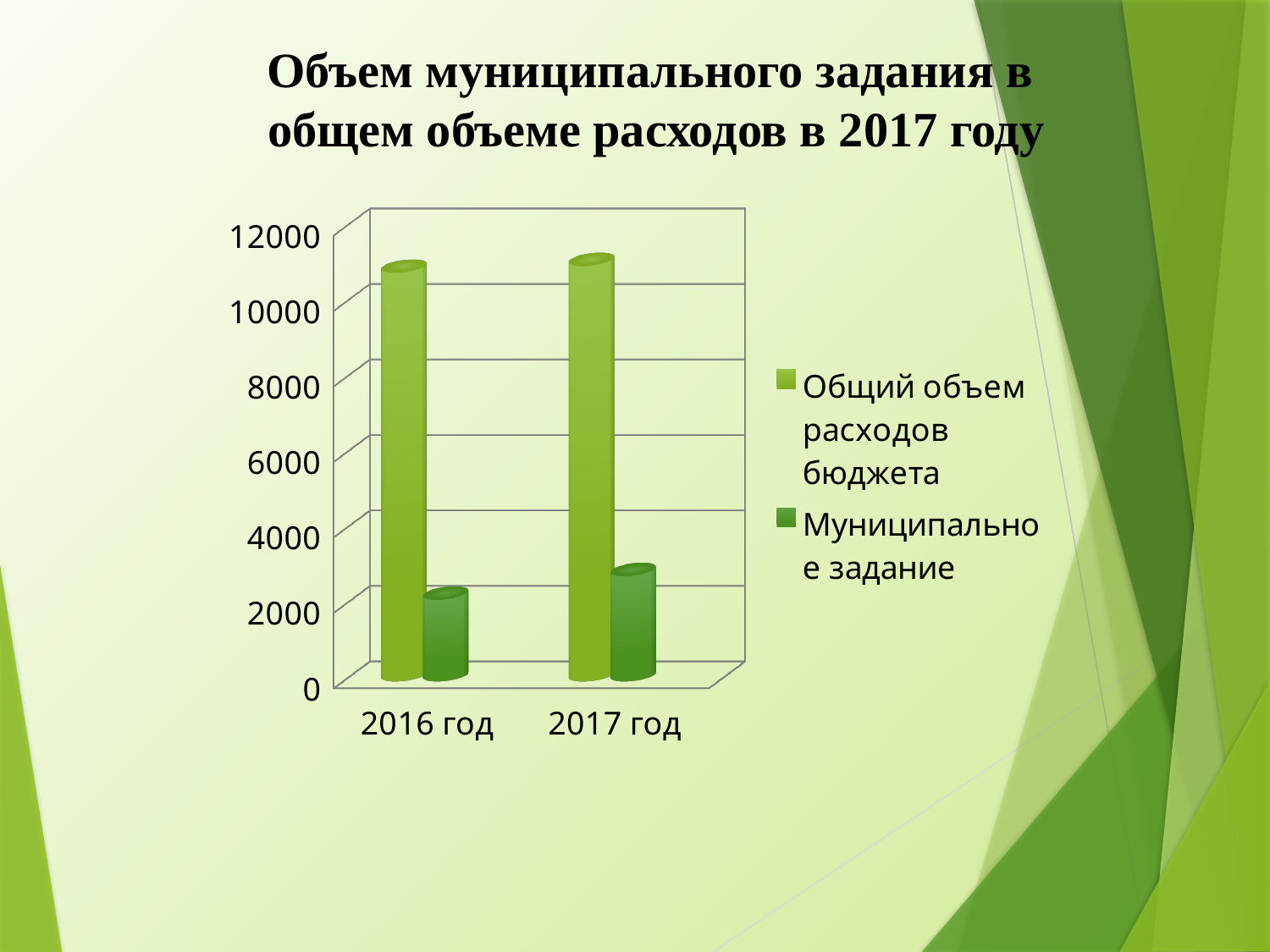
In 2017 год, which is larger: Общий объем расходов бюджета or Муниципальное задание? Общий объем расходов бюджета Is the value for Муниципальное задание in 2017 год greater or less than 4000? less Is the value for Общий объем расходов бюджета in 2016 год greater or less than 10000? greater What are the two categories on the x axis? 2016 год, 2017 год Does the value for Муниципальное задание rise or fall from 2016 год to 2017 год? rise What type of chart is shown on the slide? Bar chart Is the value for Общий объем расходов бюджета in 2017 год greater or less than 10000? greater How many categories are shown on the x axis? 2 In which year is the value for Муниципальное задание higher? 2017 год What is the title of the chart? Объем муниципального задания в общем объеме расходов в 2017 году How many series does the legend list? 2